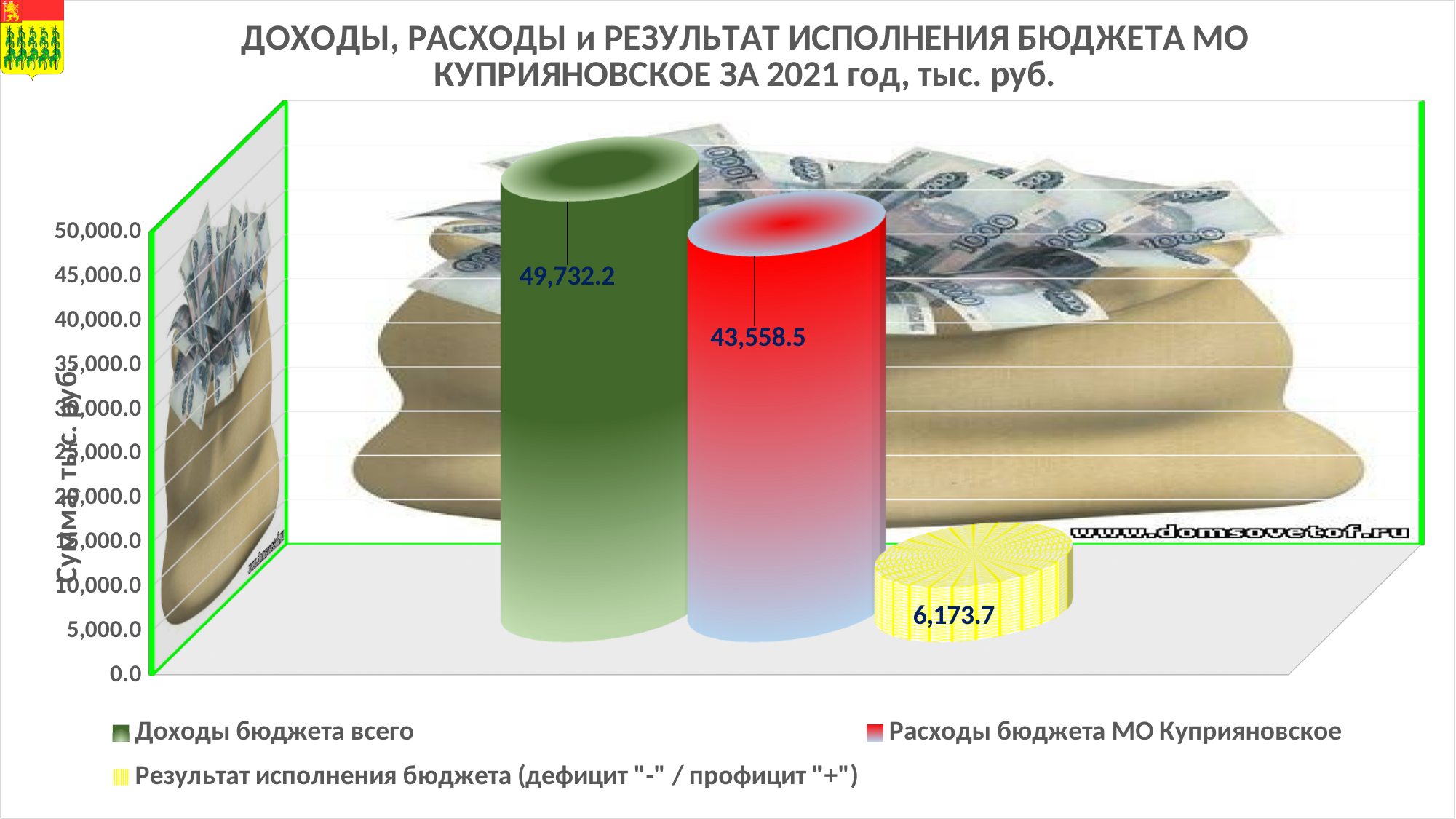
Which series has the highest value? Доходы бюджета всего Is the value for Расходы бюджета МО Куприяновское greater or less than 40,000.0? greater What is the label of the vertical axis? Сумма, тыс. руб. What is the value for Результат исполнения бюджета (дефицит "-" / профицит "+")? 6,173.7 Which is larger, Доходы бюджета всего or Расходы бюджета МО Куприяновское? Доходы бюджета всего What kind of chart is shown on the slide? bar chart What is the difference between Доходы бюджета всего and Расходы бюджета МО Куприяновское? 6,173.7 Is the value for Результат исполнения бюджета greater or less than 10,000.0? less What is the value for Расходы бюджета МО Куприяновское? 43,558.5 Which series has the lowest value? Результат исполнения бюджета (дефицит "-" / профицит "+") What is the value for Доходы бюджета всего? 49,732.2 How many series does the legend list? 3